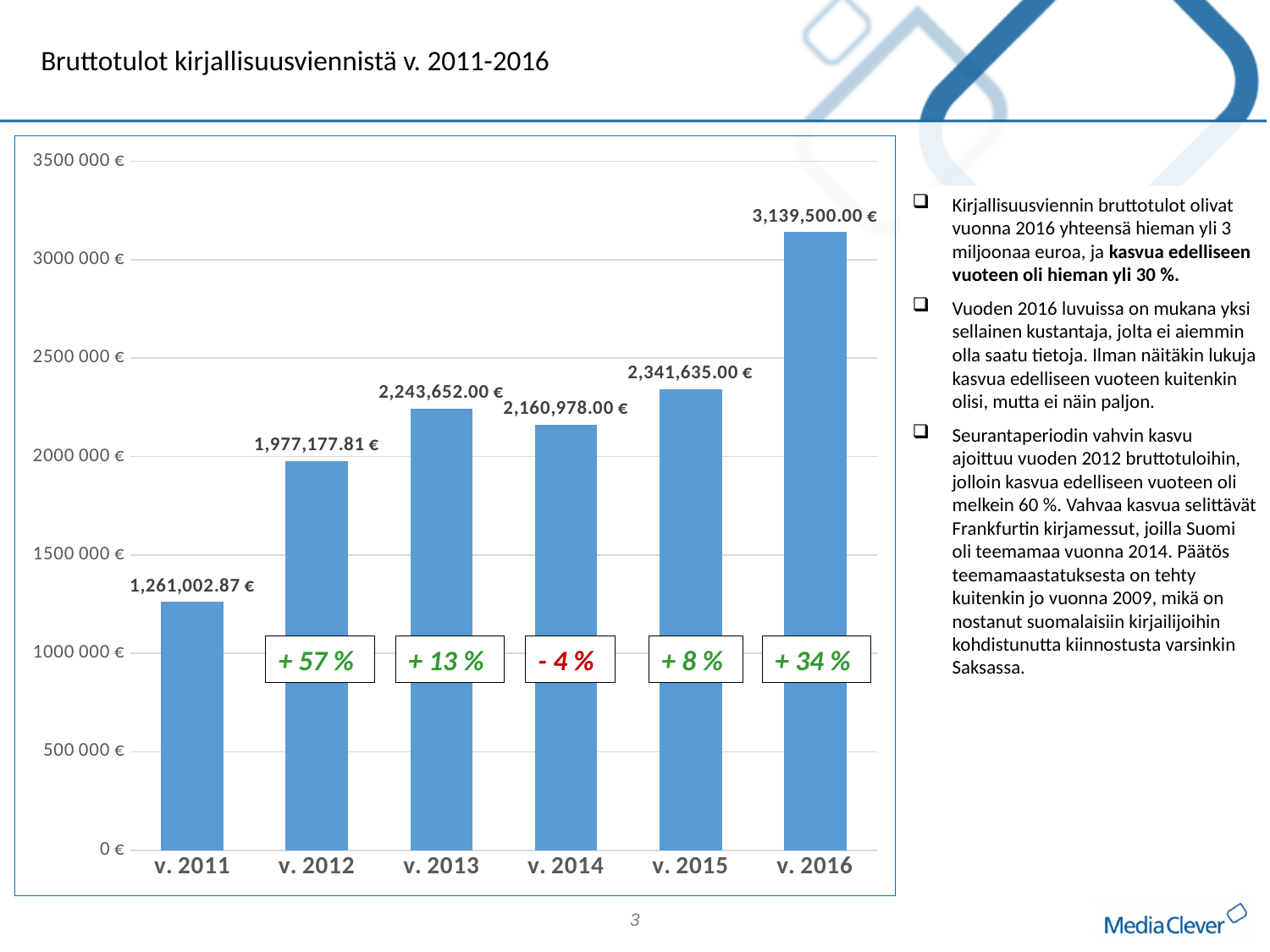
What is the value for v. 2011? 1,261,002.87 € What percentage change is shown in the box between v. 2013 and v. 2014? - 4 % What is the difference between the values for v. 2013 and v. 2014? 82,674.00 € What is the value for v. 2016? 3,139,500.00 € Is the value for v. 2011 greater or less than 1500 000 €? less Which is larger, the value for v. 2013 or the value for v. 2014? v. 2013 What is the value for v. 2014? 2,160,978.00 € What is the difference between the values for v. 2016 and v. 2015? 797,865.00 € How many years are shown on the x axis? 6 Which year has the highest value? v. 2016 Which year has the lowest value? v. 2011 What kind of chart is shown on the slide? Bar chart